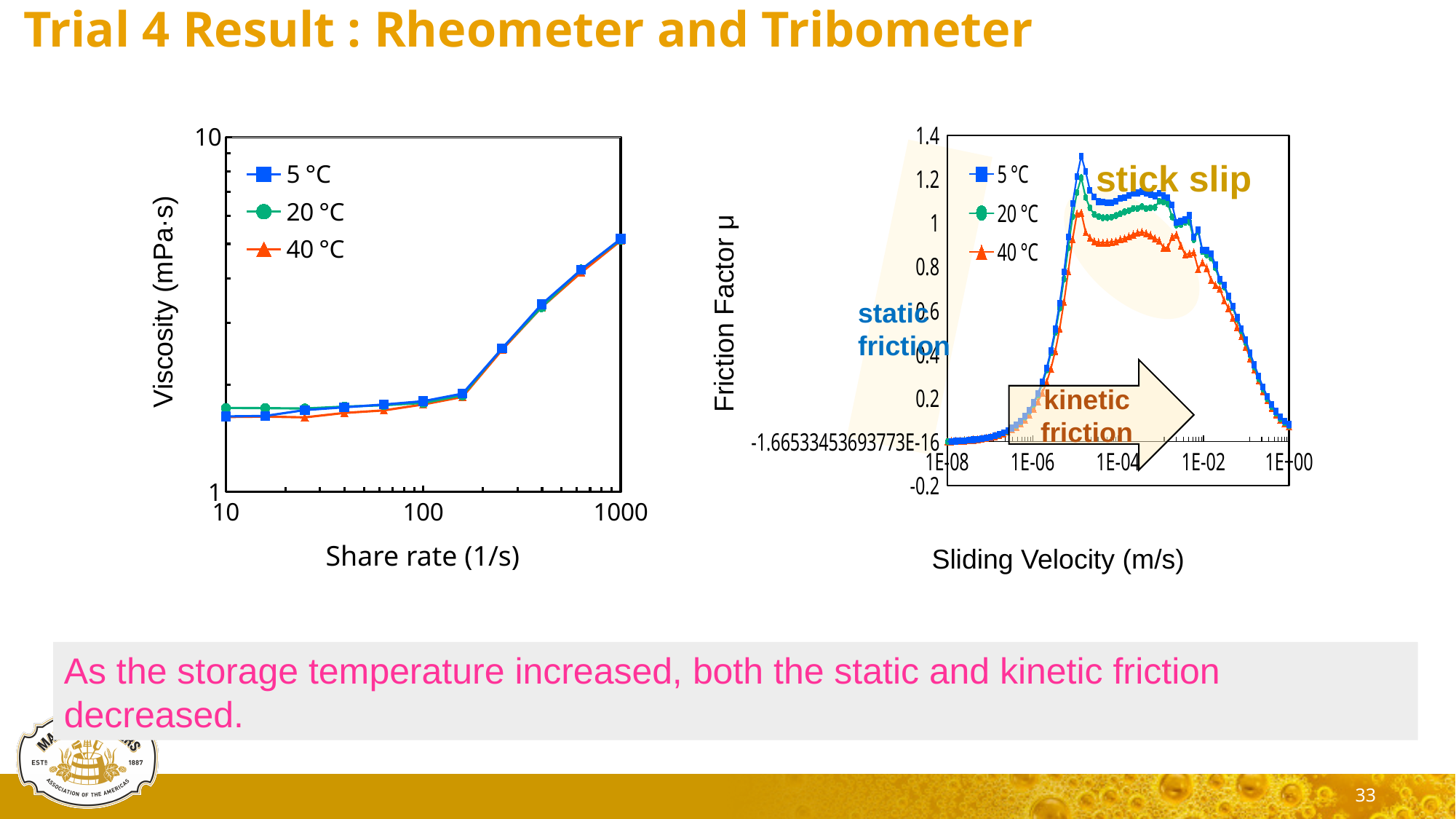
On the left chart, does viscosity rise or fall as the share rate increases from 100 to 1000 1/s? Rise On the right chart, is the peak friction factor for 40 °C greater or less than 1.2? less On the left chart, is the viscosity at a share rate of 1000 1/s greater or less than 1 mPa·s? greater On the right chart, which series has the lowest peak friction factor? 40 °C On the right chart, at the peak, is the friction factor for 5 °C or for 40 °C larger? 5 °C On the right chart, does the friction factor rise or fall as sliding velocity increases from 1E-02 to 1E+00 m/s? Fall On the left chart (Viscosity vs Share rate), how many series does the legend list? 3 On the right chart, what is the label of the y axis? Friction Factor μ On the right chart (Friction Factor vs Sliding Velocity), how many series does the legend list? 3 On the left chart, what is the label of the x axis? Share rate (1/s) What kind of chart is the left chart showing viscosity against share rate? Line chart On the right chart, which series reaches the highest peak friction factor? 5 °C